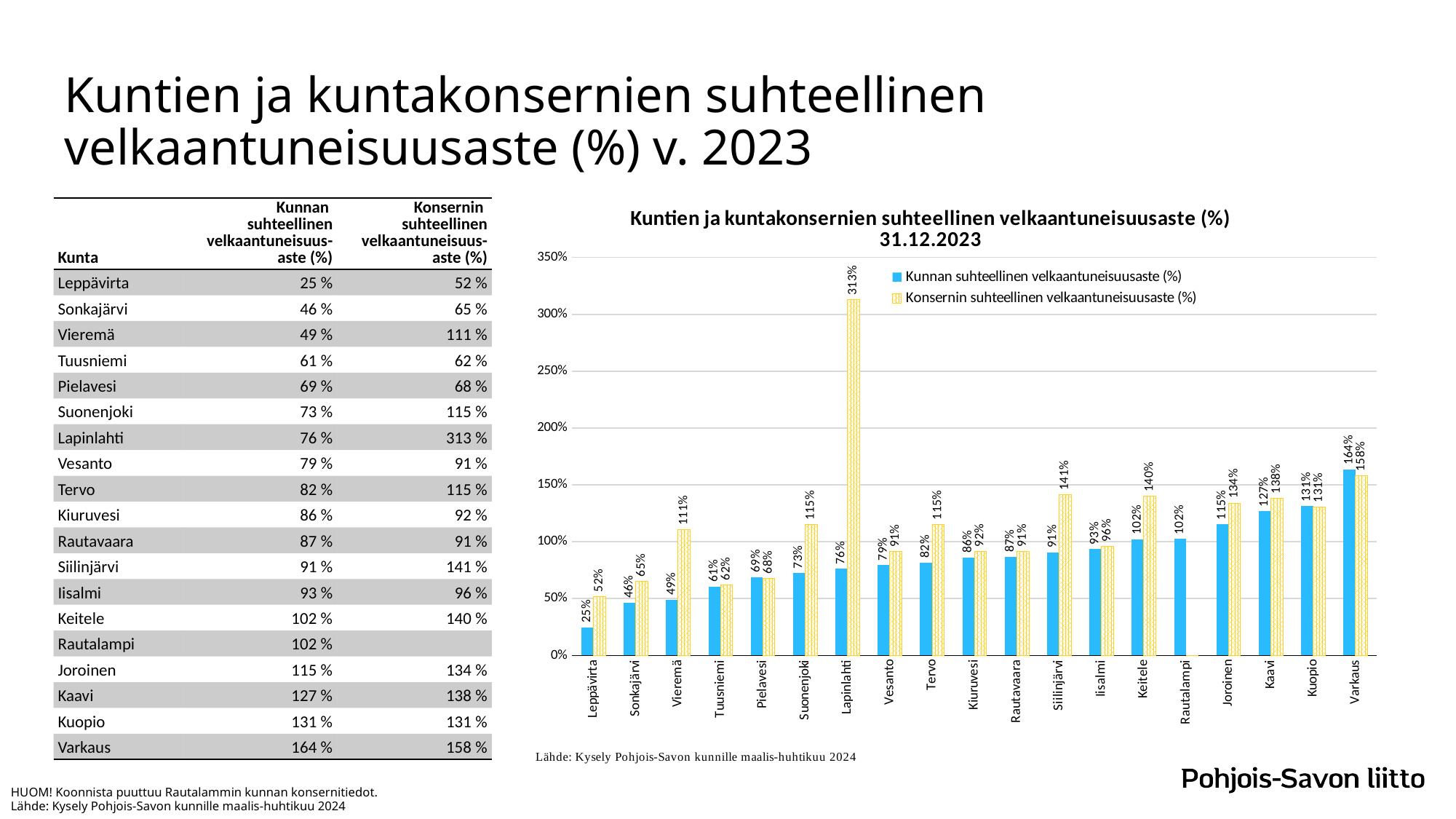
What is the difference between the Kunnan and Konsernin values for Varkaus? 6 percentage points Which municipality has the highest Konsernin suhteellinen velkaantuneisuusaste (%)? Lapinlahti Is the Kunnan suhteellinen velkaantuneisuusaste value for Joroinen greater or less than 100%? greater For Kaavi, which is larger: the Kunnan value or the Konsernin value? Konsernin Which municipality has no Konsernin suhteellinen velkaantuneisuusaste bar in the chart? Rautalampi How many municipalities are shown on the x axis of the chart? 19 How many series does the chart legend list? 2 Which municipality has the lowest Kunnan suhteellinen velkaantuneisuusaste (%)? Leppävirta What is the Konsernin suhteellinen velkaantuneisuusaste (%) value for Lapinlahti? 313% What kind of chart is shown on the slide? bar chart Which municipality has the highest Kunnan suhteellinen velkaantuneisuusaste (%)? Varkaus What is the Kunnan suhteellinen velkaantuneisuusaste (%) value for Kuopio? 131%